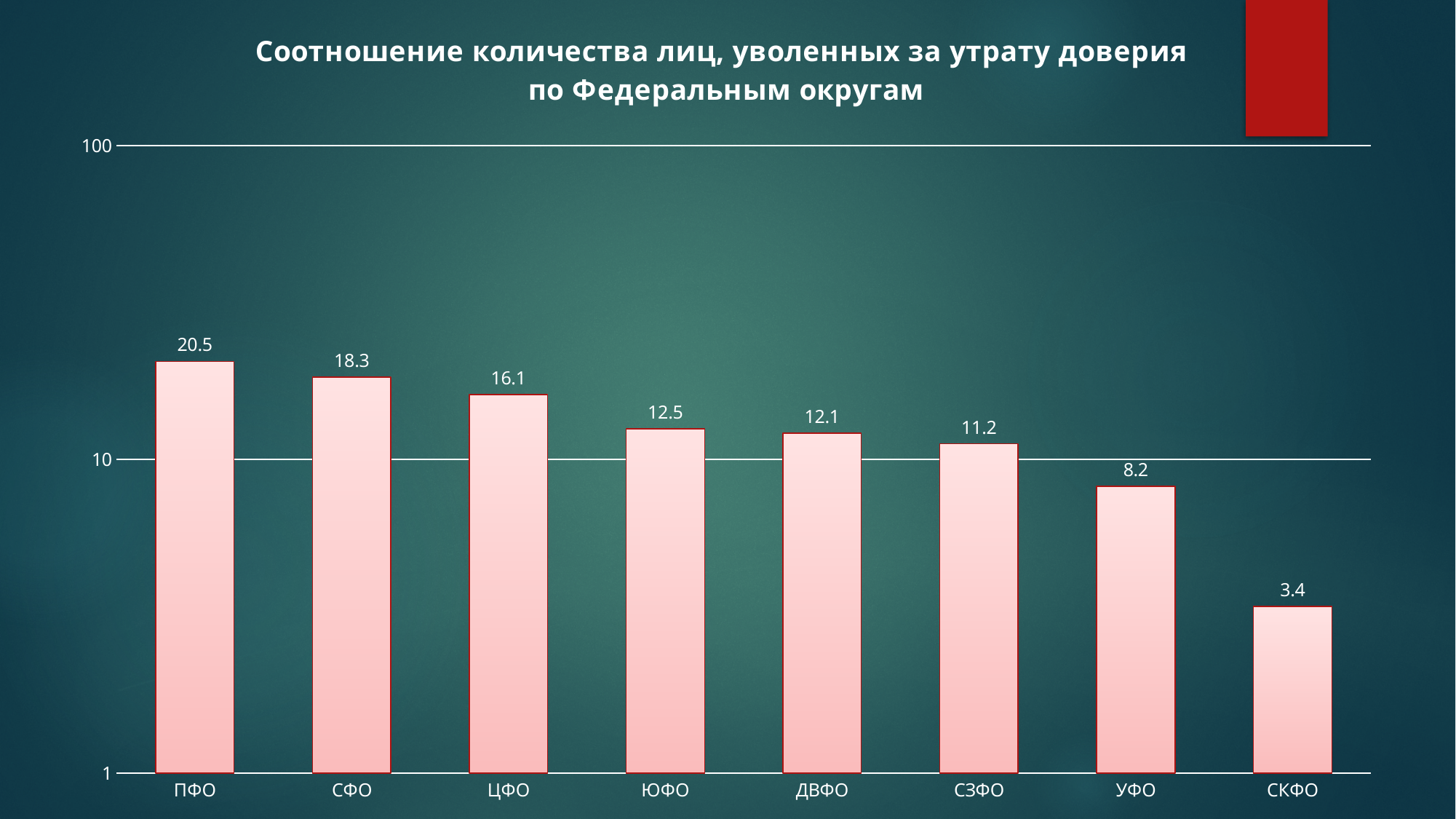
What is the title of the chart? Соотношение количества лиц, уволенных за утрату доверия по Федеральным округам Do the values rise or fall from left to right along the x axis? fall Which category has the highest value? ПФО Which category has the lowest value? СКФО What kind of chart is shown on the slide? bar chart What is the value for ПФО? 20.5 What is the value for ДВФО? 12.1 What is the difference between the values for ПФО and СФО? 2.2 Which is larger, the value for ЮФО or the value for УФО? ЮФО How many categories are shown on the x axis? 8 What is the value for СКФО? 3.4 Is the value for УФО greater or less than 10? less